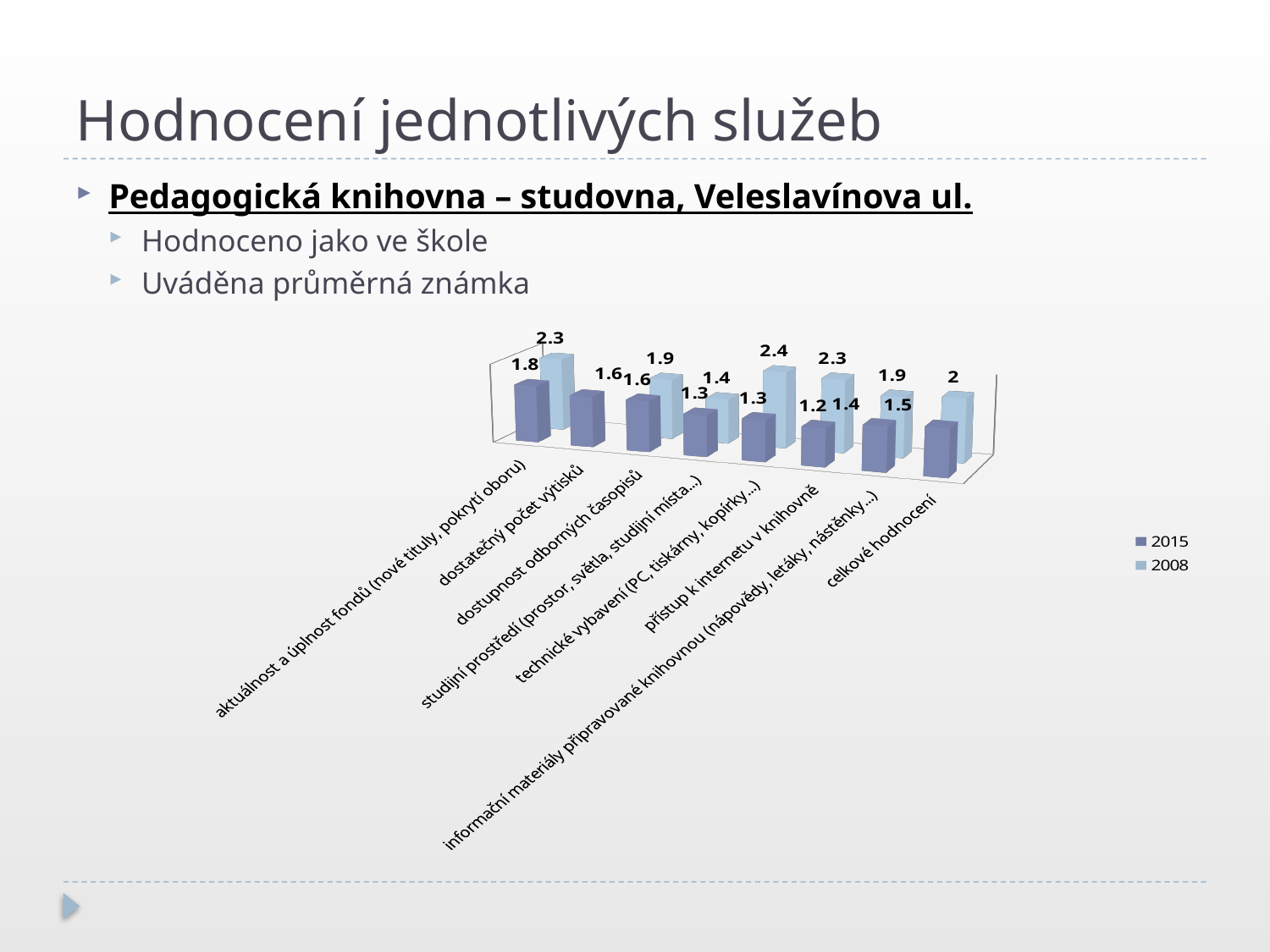
What is the 2015 value for 'celkové hodnocení'? 1.5 What is the 2008 value for 'aktuálnost a úplnost fondů (nové tituly, pokrytí oboru)'? 2.3 For 'celkové hodnocení', which series has the larger value, 2015 or 2008? 2008 What is the 2008 value for 'celkové hodnocení'? 2 What is the 2015 value for 'aktuálnost a úplnost fondů (nové tituly, pokrytí oboru)'? 1.8 What is the difference between the 2008 and 2015 values for 'aktuálnost a úplnost fondů (nové tituly, pokrytí oboru)'? 0.5 How many series does the chart legend list? 2 Which category has the highest 2008 value? technické vybavení (PC, tiskárny, kopírky...) How many categories are shown on the chart's x axis? 8 Which category has the lowest 2015 value? přístup k internetu v knihovně What type of chart is shown on the slide? bar chart Which series is shown in the darker blue colour in the legend? 2015